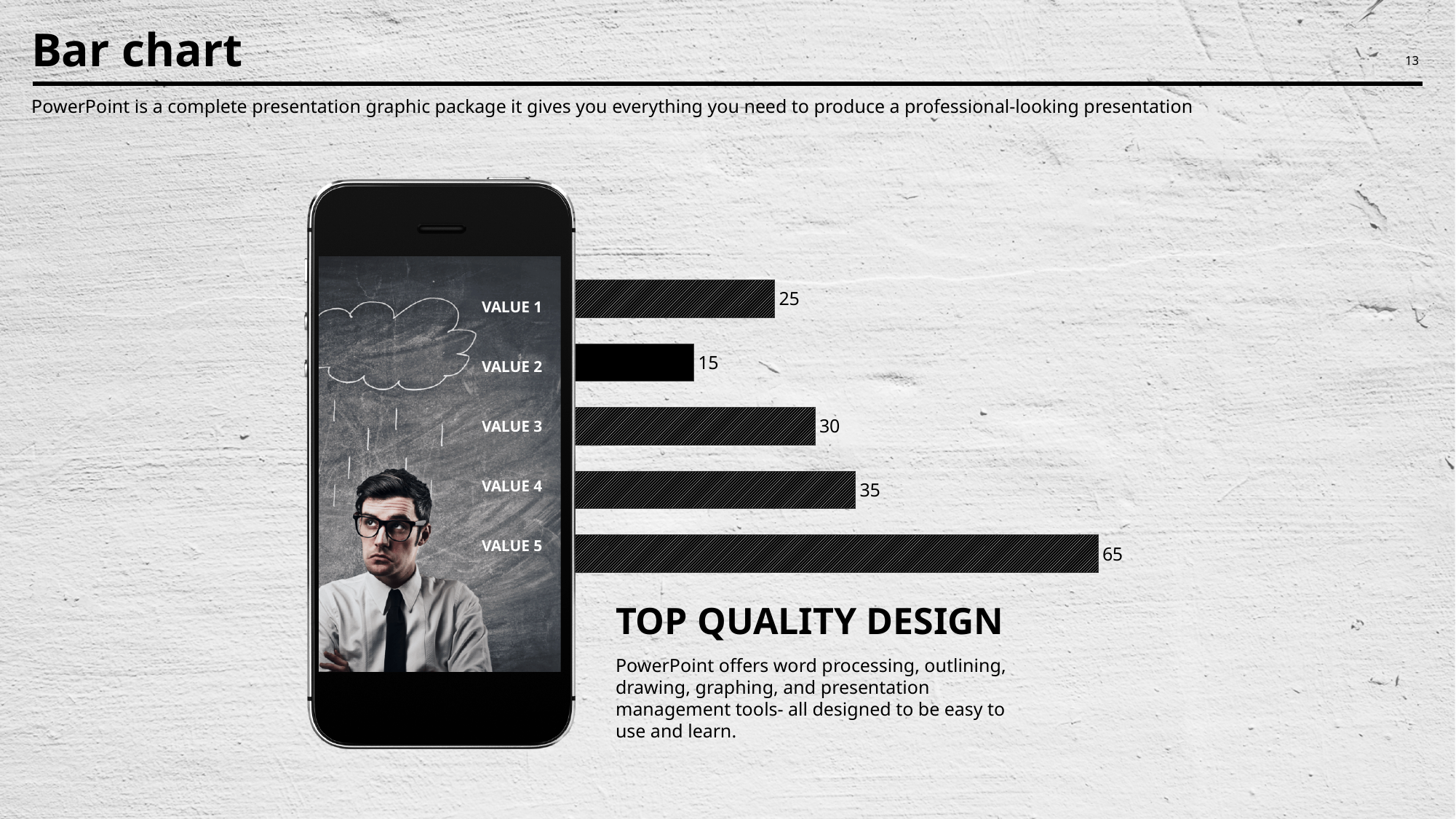
Which category has the highest value? VALUE 5 Which category has the lowest value? VALUE 2 What is the value for VALUE 3? 30 What is the title of the slide containing the chart? Bar chart What is the value for VALUE 4? 35 What is the difference between the values for VALUE 5 and VALUE 4? 30 How many categories are shown in the chart? 5 What kind of chart is shown on the slide? Bar chart What is the value for VALUE 2? 15 What is the value for VALUE 1? 25 What is the value for VALUE 5? 65 Which is larger, the value for VALUE 1 or the value for VALUE 3? VALUE 3